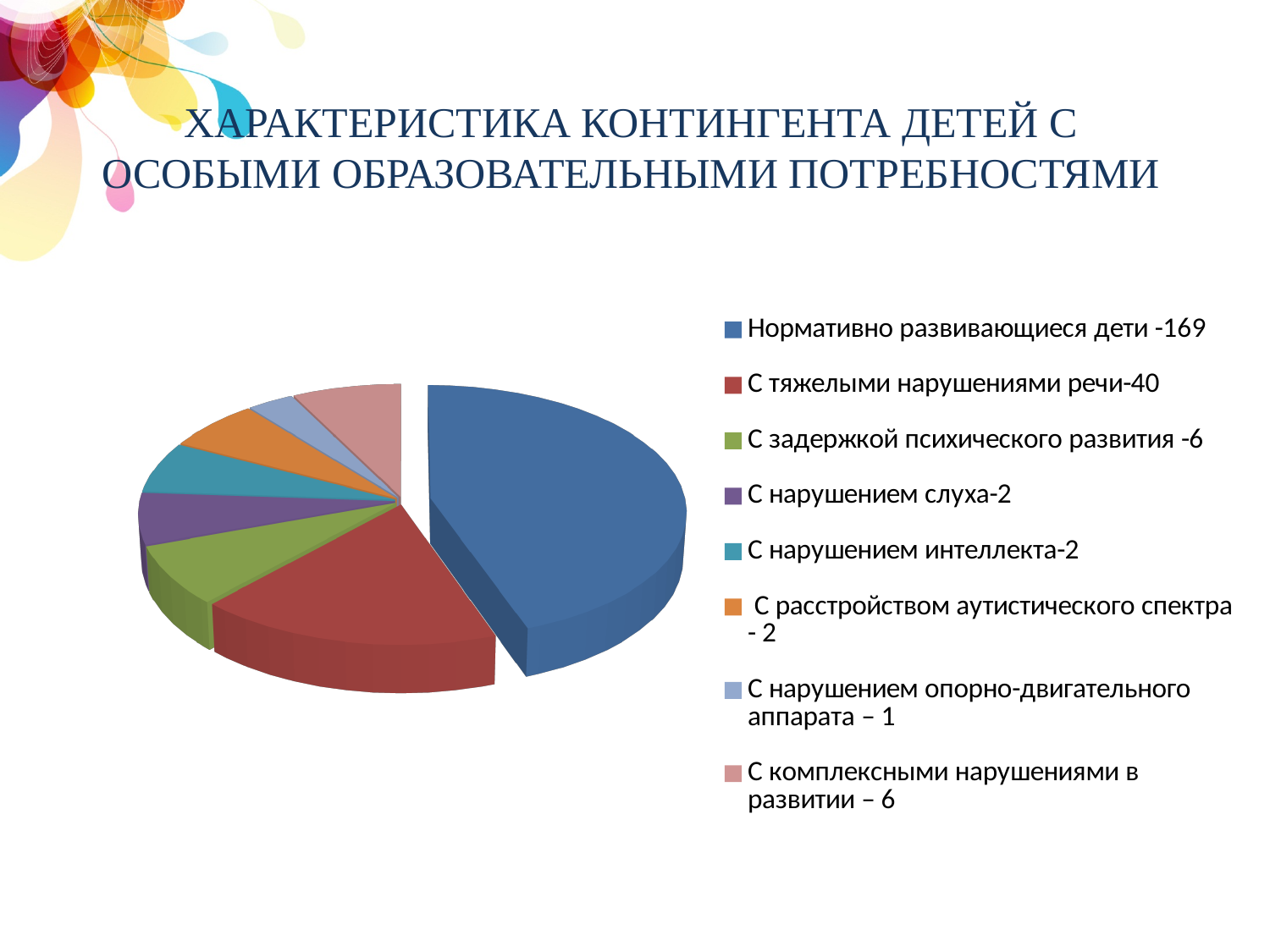
By how much does the legend value for 'Нормативно развивающиеся дети' exceed the value for 'С тяжелыми нарушениями речи'? 129 Which category has the largest slice of the pie chart? Нормативно развивающиеся дети -169 What type of chart is shown on the slide? pie chart What colour is the slice for 'Нормативно развивающиеся дети'? blue What number is given in the legend for 'С нарушением слуха'? 2 What number is given in the legend for 'С задержкой психического развития'? 6 Which category has the smallest slice of the pie chart? С нарушением опорно-двигательного аппарата – 1 What number is given in the legend for 'С комплексными нарушениями в развитии'? 6 What number is given in the legend for 'С тяжелыми нарушениями речи'? 40 Which slice is larger: 'С тяжелыми нарушениями речи' or 'С задержкой психического развития'? С тяжелыми нарушениями речи What number is given in the legend for 'Нормативно развивающиеся дети'? 169 How many categories does the pie chart have? 8